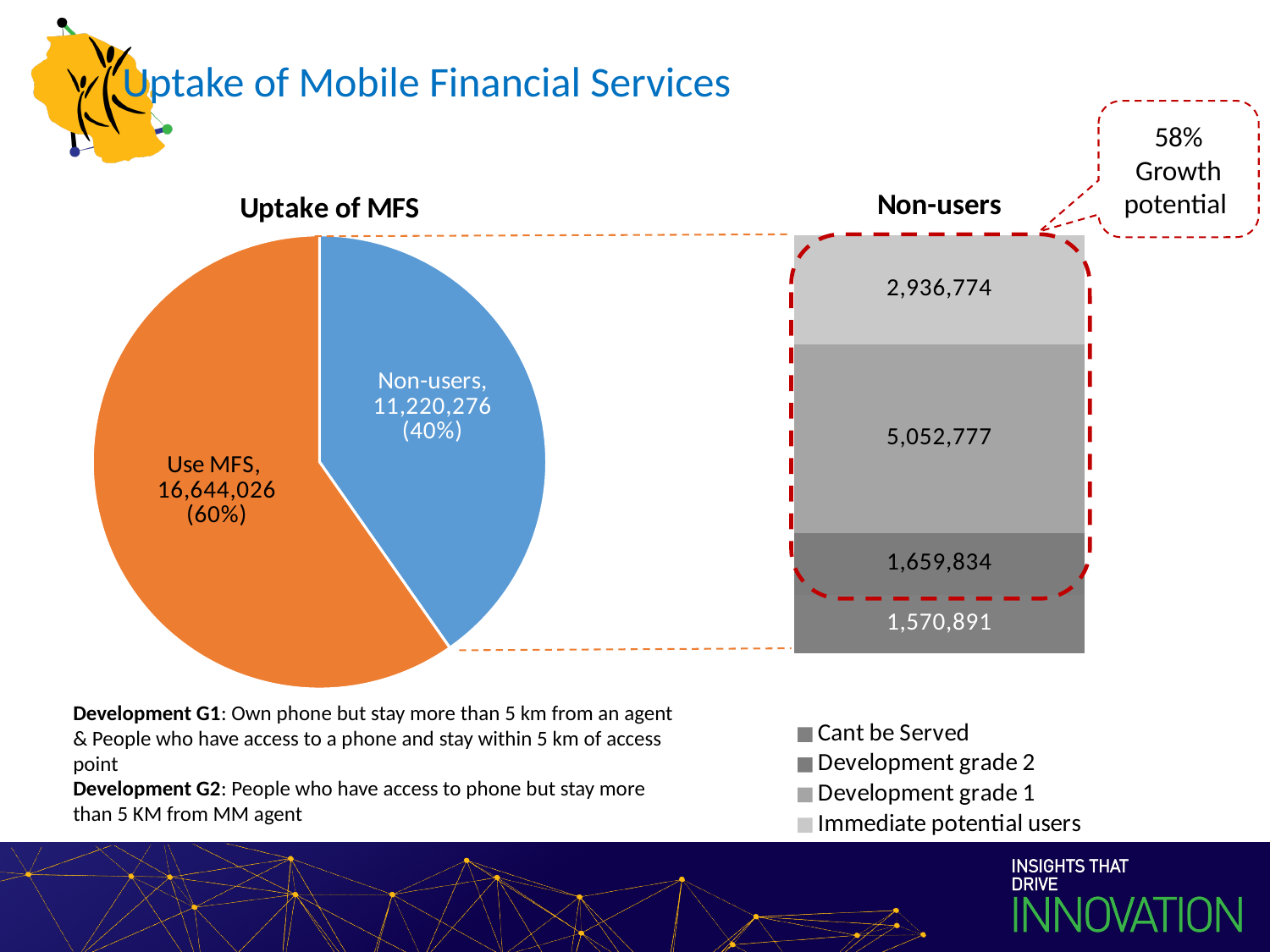
What growth potential percentage is shown in the callout next to the 'Non-users' bar chart? 58% How many entries does the legend of the 'Non-users' stacked bar chart list? 4 In the 'Uptake of MFS' pie chart, what percentage share do Non-users have? 40% In the 'Non-users' stacked bar chart on the right, what is the total of all the segments? 11,220,276 In the 'Uptake of MFS' pie chart, what value is shown for Use MFS? 16,644,026 How many slices does the 'Uptake of MFS' pie chart have? 2 In the 'Non-users' stacked bar chart, what is the value of the topmost (lightest) segment, Immediate potential users? 2,936,774 In the 'Non-users' stacked bar chart, what is the value of the smallest segment? 1,570,891 In the 'Uptake of MFS' pie chart, which slice is the largest? Use MFS What kind of chart is the 'Uptake of MFS' chart on the left? Pie chart In the 'Uptake of MFS' pie chart, what is the difference between the Use MFS value and the Non-users value? 5,423,750 In the 'Non-users' stacked bar chart, what is the value of the largest segment? 5,052,777